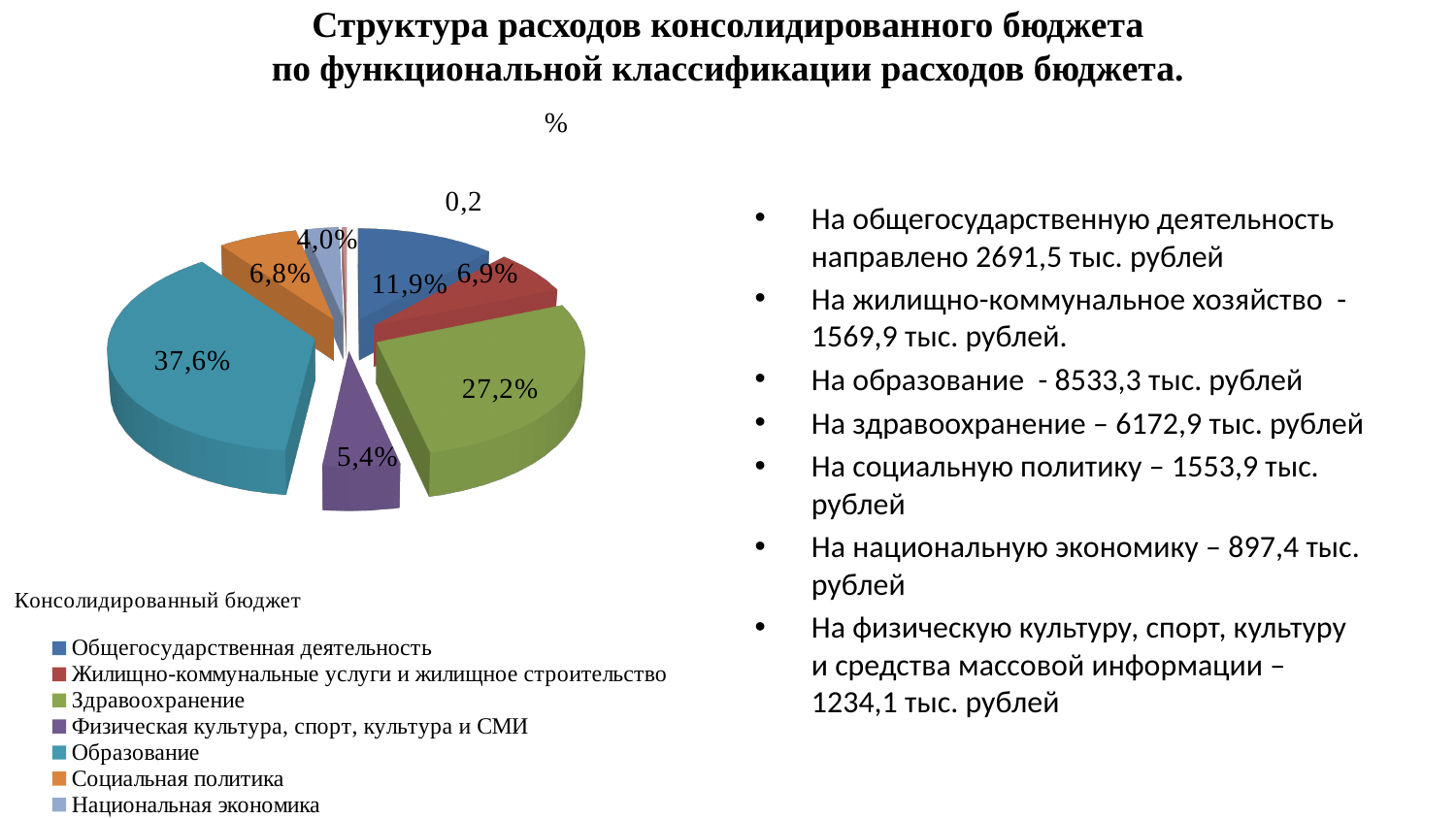
What share of the pie does Национальная экономика have? 4,0% What share of the pie does Физическая культура, спорт, культура и СМИ have? 5,4% What share of the pie does Здравоохранение have? 27,2% What kind of chart is shown on the slide? Pie chart Which has the larger share: Общегосударственная деятельность or Жилищно-коммунальные услуги и жилищное строительство? Общегосударственная деятельность What is the difference in percentage points between the shares of Образование and Здравоохранение? 10,4 What share of the pie does Образование have? 37,6% Which category has the largest share of the pie? Образование How many entries does the chart legend list? 7 What share of the pie does Жилищно-коммунальные услуги и жилищное строительство have? 6,9% What share of the pie does Общегосударственная деятельность have? 11,9% What share of the pie does Социальная политика have? 6,8%